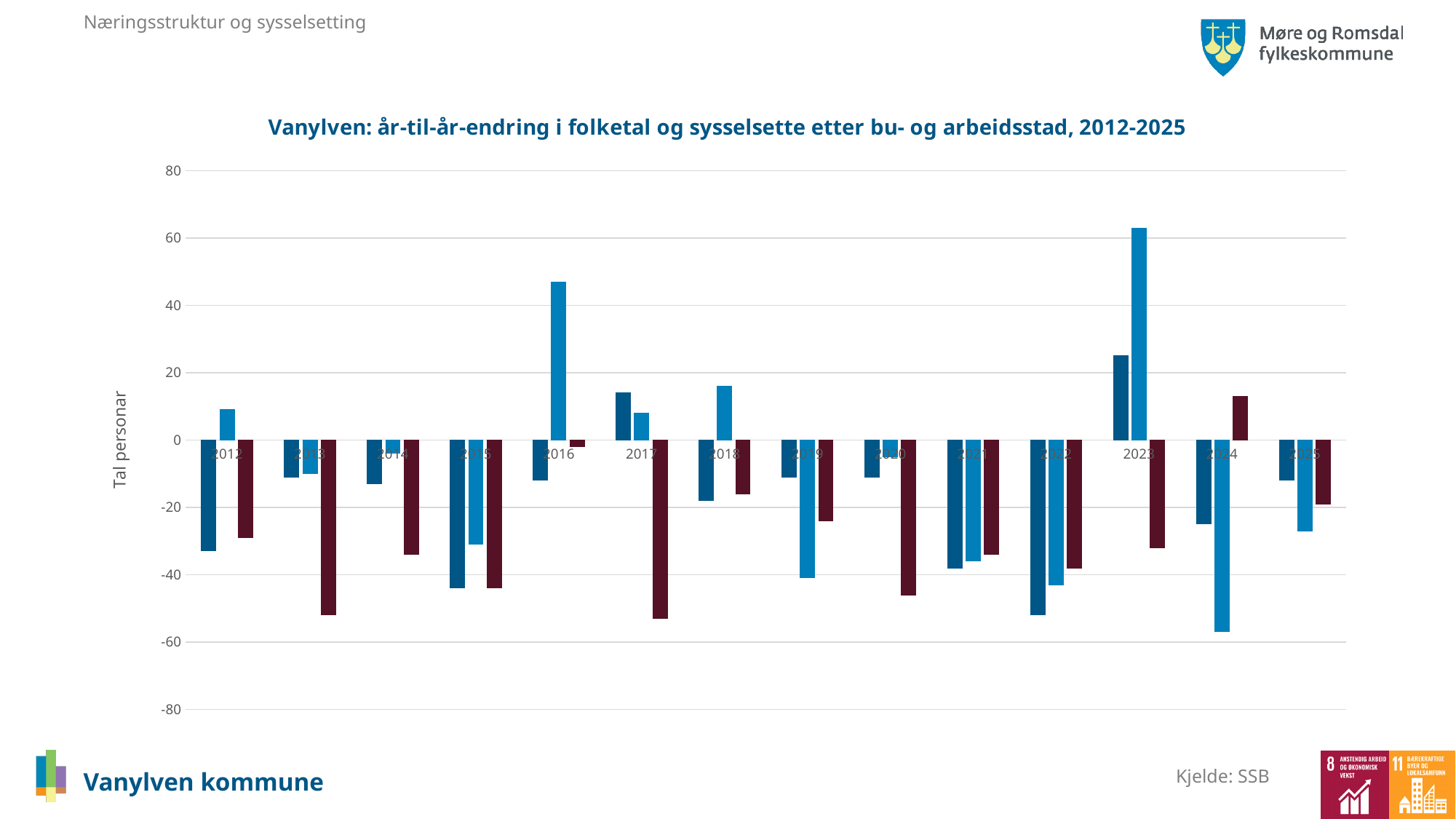
In which year does the chart show the tallest positive bar? 2023 What is the label on the vertical axis of the chart? Tal personar What is the title of the chart? Vanylven: år-til-år-endring i folketal og sysselsette etter bu- og arbeidsstad, 2012-2025 Is the value of the dark blue bar for 2022 greater or less than -40? less Is the value of the light blue bar for 2024 greater or less than -40? less Is the value of the dark blue bar for 2023 greater or less than 20? greater How many years are shown along the x axis of the chart? 14 Which year has the higher light blue bar, 2016 or 2023? 2023 Which year has the higher dark red bar, 2012 or 2013? 2012 What kind of chart is shown on the slide? Bar chart